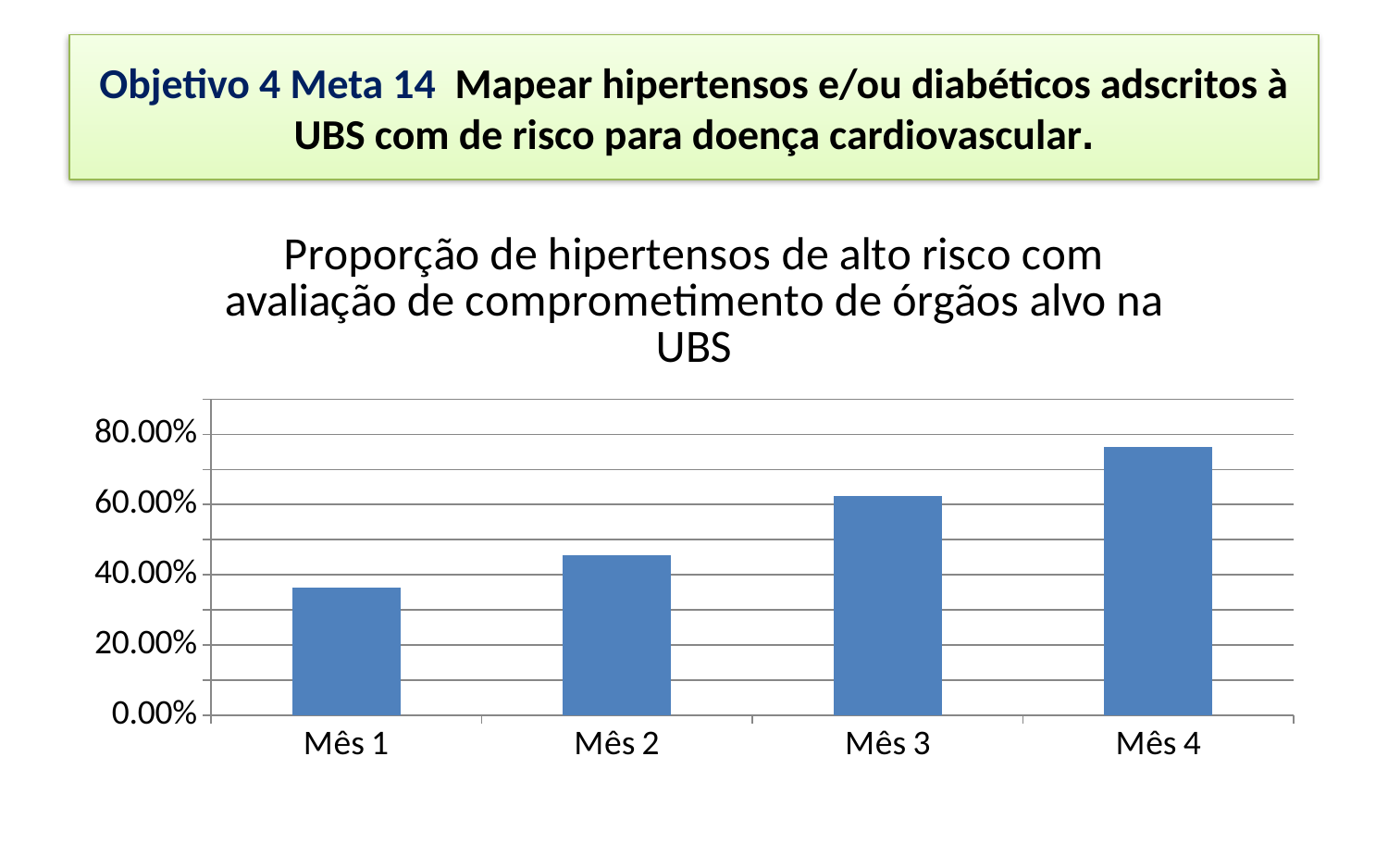
Is the value for Mês 3 greater or less than 60.00%? greater How many months (categories) are plotted on the x axis? 4 What is the title of the chart? Proporção de hipertensos de alto risco com avaliação de comprometimento de órgãos alvo na UBS Which month has the highest proportion? Mês 4 Do the values rise or fall from Mês 1 to Mês 4? rise What kind of chart is shown on the slide? bar chart Which month has the lowest proportion? Mês 1 Is the value for Mês 2 greater or less than 40.00%? greater What is the highest value labelled on the y axis? 80.00% Which is larger, the value for Mês 3 or the value for Mês 2? Mês 3 Is the value for Mês 1 greater or less than 40.00%? less